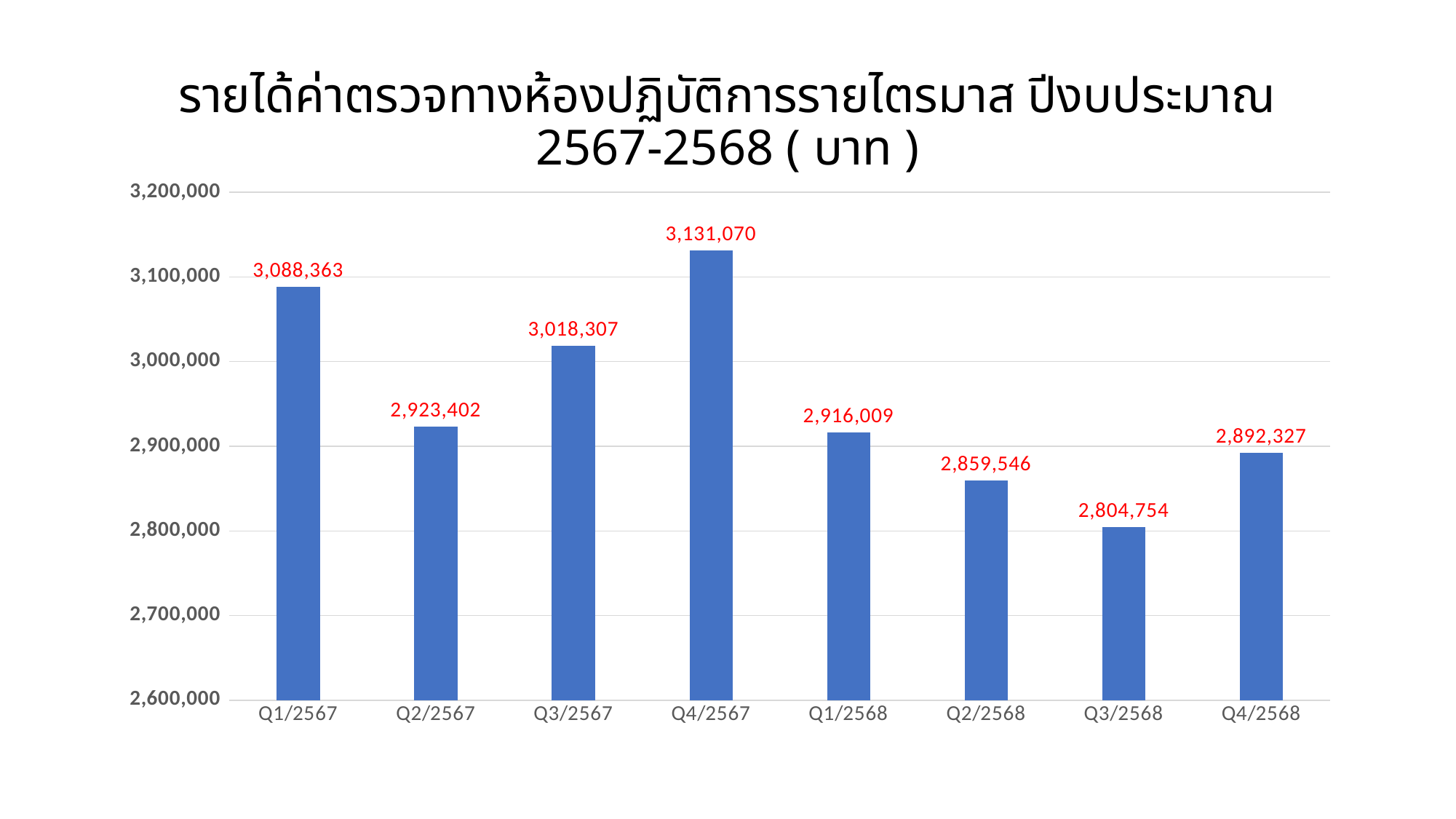
What is the value for Q3/2568? 2,804,754 Is the value for Q2/2568 greater or less than 2,900,000? less Which is larger, the value for Q3/2567 or the value for Q4/2568? Q3/2567 What kind of chart is shown on the slide? bar chart What is the value for Q2/2567? 2,923,402 Which quarter has the lowest value? Q3/2568 What is the value for Q4/2567? 3,131,070 Which quarter has the highest value? Q4/2567 What is the difference between the values for Q1/2567 and Q1/2568? 172,354 How many quarters are shown on the x axis? 8 What is the difference between the values for Q4/2567 and Q3/2568? 326,316 Do the values rise or fall from Q4/2567 to Q3/2568? fall